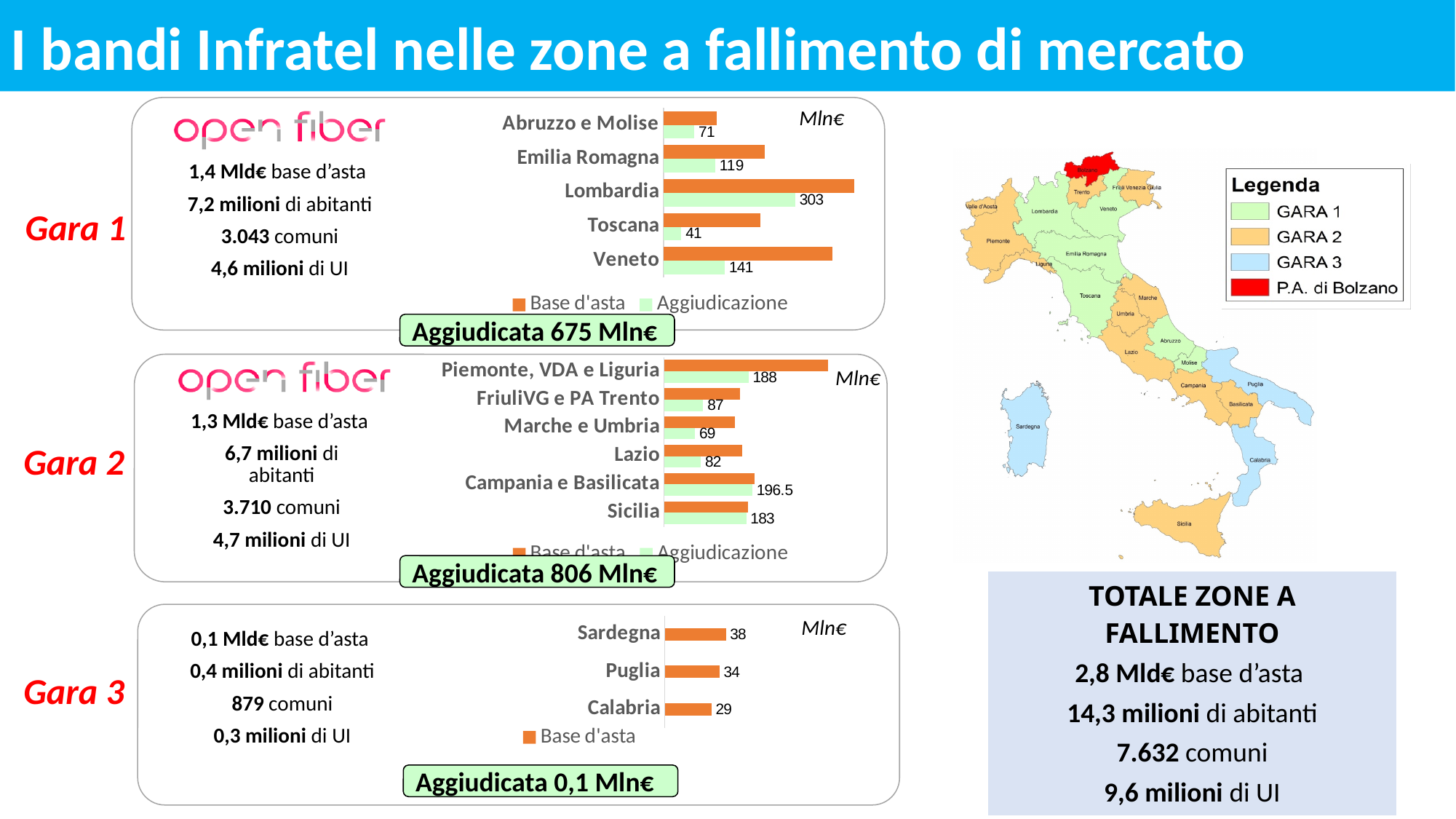
In the Gara 1 chart, which category has the lowest Aggiudicazione value? Toscana In the Gara 3 chart, what is the difference between the Base d'asta values for Sardegna and Puglia? 4 In the Gara 1 chart, what is the Aggiudicazione value for Lombardia? 303 What kind of chart is the Gara 3 chart? bar chart In the Gara 2 chart, how many categories are plotted? 6 In the Gara 3 chart, what is the Base d'asta value for Calabria? 29 In the Gara 2 chart, is the Aggiudicazione value for Lazio larger or smaller than that for Marche e Umbria? larger In the Gara 1 chart, how many series does the legend list? 2 In the Gara 2 chart, which category has the highest Aggiudicazione value? Campania e Basilicata In the Gara 2 chart, what is the Aggiudicazione value for Campania e Basilicata? 196.5 In the Gara 1 chart, what is the difference between the Aggiudicazione values for Veneto and Emilia Romagna? 22 In the Gara 3 chart, which category has the highest Base d'asta value? Sardegna